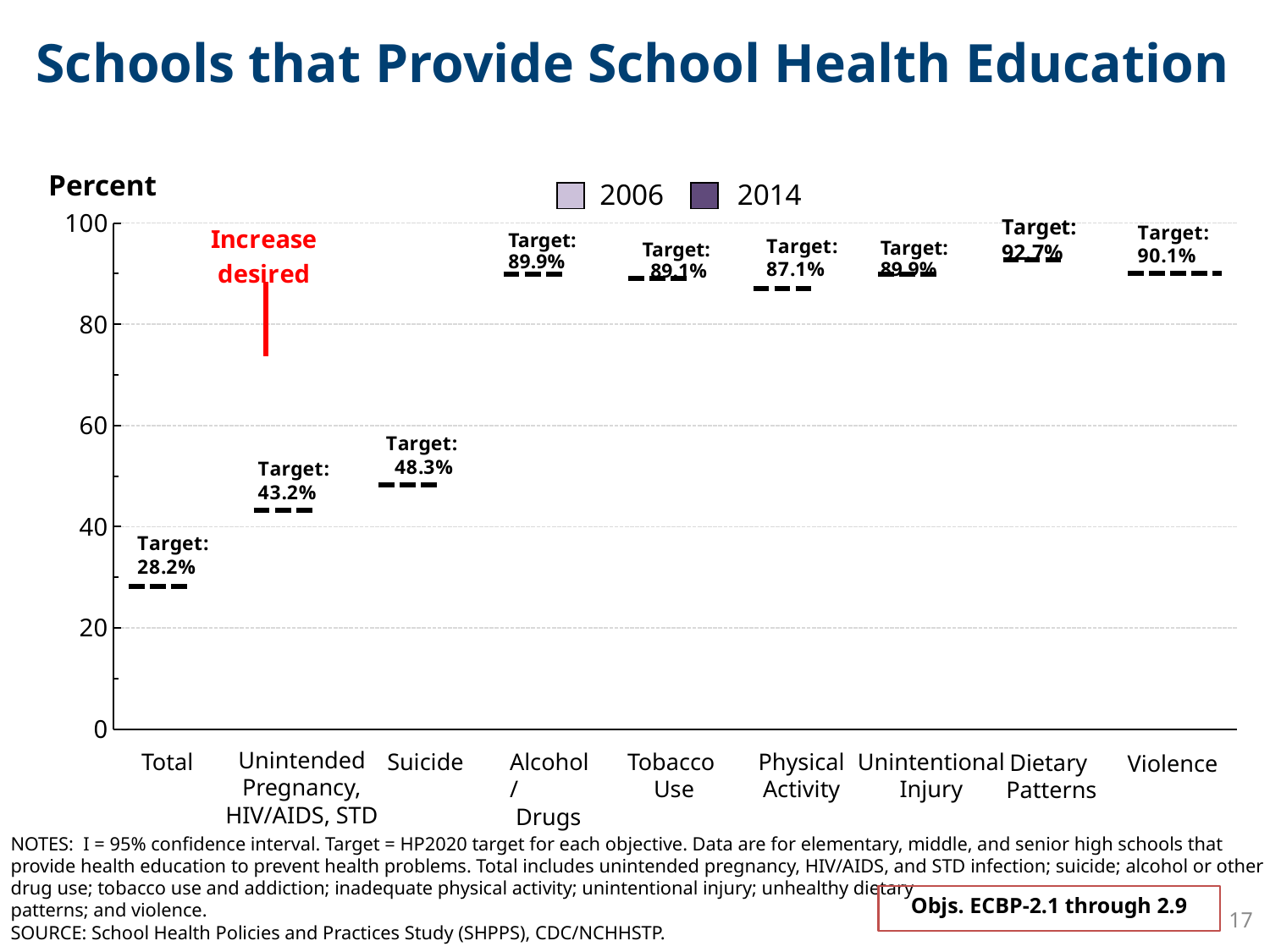
How many categories are shown along the x axis? 9 Which category has the highest target value shown on the chart? Dietary Patterns What is the target value shown for Dietary Patterns? 92.7% What is the HP2020 target shown for Total? 28.2% Which has a higher target, Violence or Tobacco Use? Violence What is the target value shown for Suicide? 48.3% Which category has the lowest target value shown on the chart? Total How many series does the legend list? 2 What years are listed in the legend? 2006 and 2014 What is the difference between the target for Suicide and the target for Unintended Pregnancy, HIV/AIDS, STD? 5.1% What is the target value shown for Physical Activity? 87.1% Is the target for Alcohol/Drugs greater or less than 80? greater